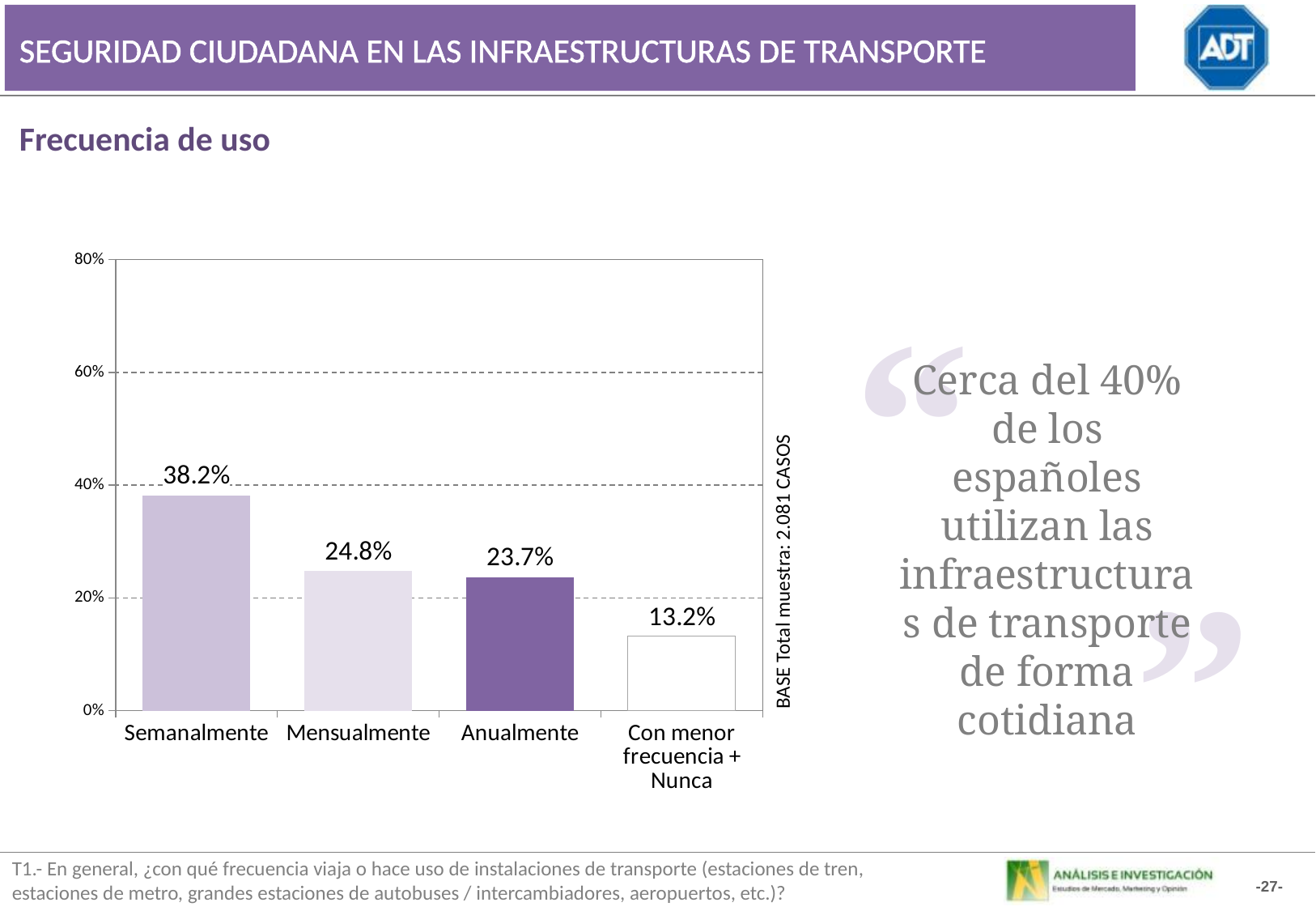
Which category has the lowest value? Con menor frecuencia + Nunca Do the values rise or fall from left to right along the x axis? Fall What is the value for Semanalmente? 38.2% Which is larger, the value for Semanalmente or the value for Anualmente? Semanalmente What is the difference between the values for Semanalmente and Mensualmente? 13.4% What is the value for Anualmente? 23.7% What is the difference between the values for Anualmente and Con menor frecuencia + Nunca? 10.5% What is the value for Mensualmente? 24.8% What kind of chart is shown on the slide? Bar chart What is the value for Con menor frecuencia + Nunca? 13.2% Which category has the highest value? Semanalmente How many categories are shown on the x axis? 4